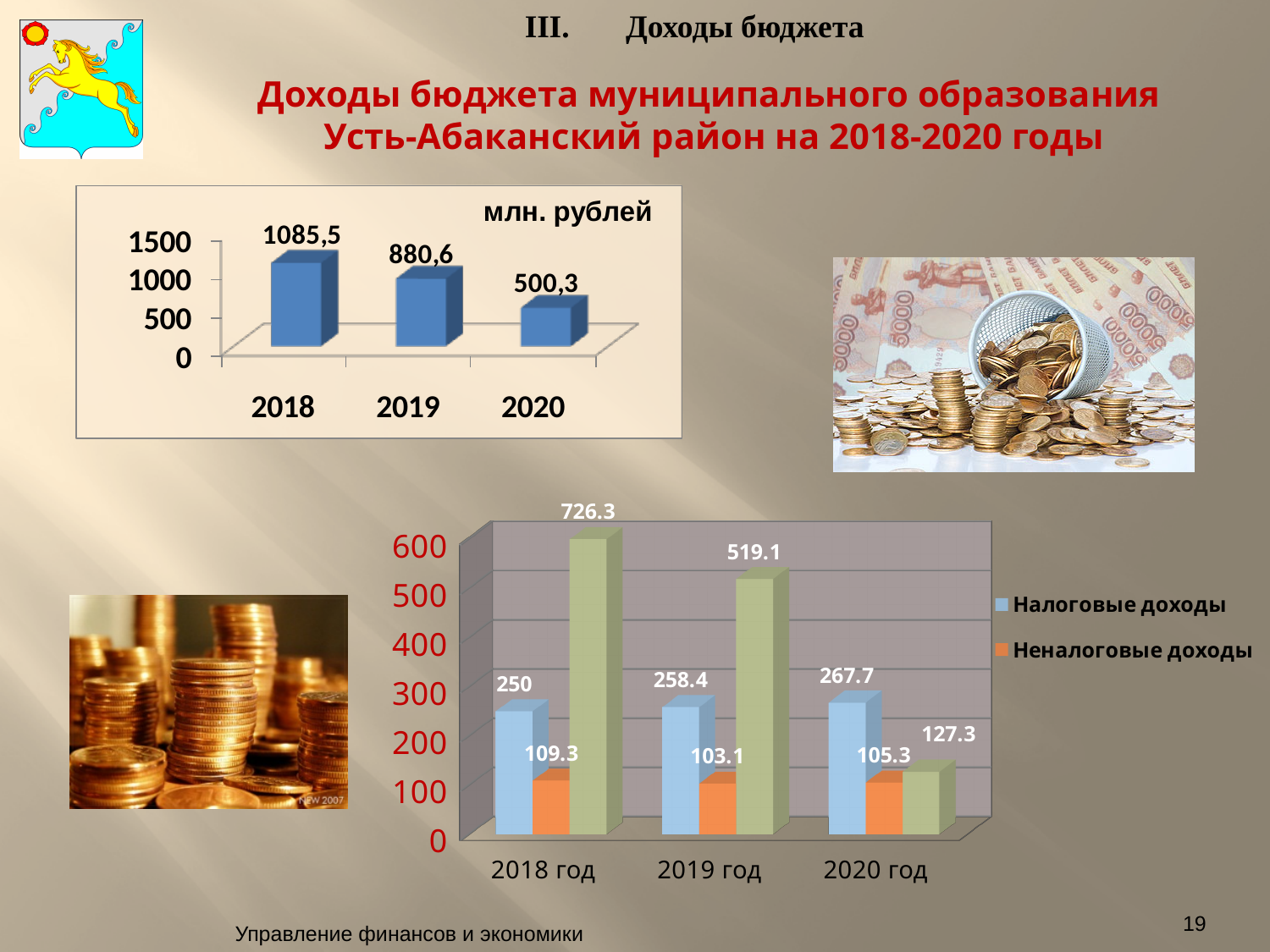
In the bottom chart, how many series does the legend list? 2 In the top chart (млн. рублей), how many years are shown? 3 In the top chart (млн. рублей), what is the difference between the 2018 and 2019 values? 204,9 What type of chart is the bottom chart? bar chart In the bottom chart, which year has the highest value of Налоговые доходы? 2020 год In the bottom chart, which is larger for 2020 год: Налоговые доходы or Неналоговые доходы? Налоговые доходы In the top chart (млн. рублей), what is the value for 2020? 500,3 In the top chart (млн. рублей), what is the value for 2018? 1085,5 In the top chart (млн. рублей), do the values rise or fall from 2018 to 2020? fall In the bottom chart, what is the value of Неналоговые доходы for 2018 год? 109.3 In the bottom chart, what is the value of Налоговые доходы for 2019 год? 258.4 In the top chart (млн. рублей), which year has the lowest value? 2020